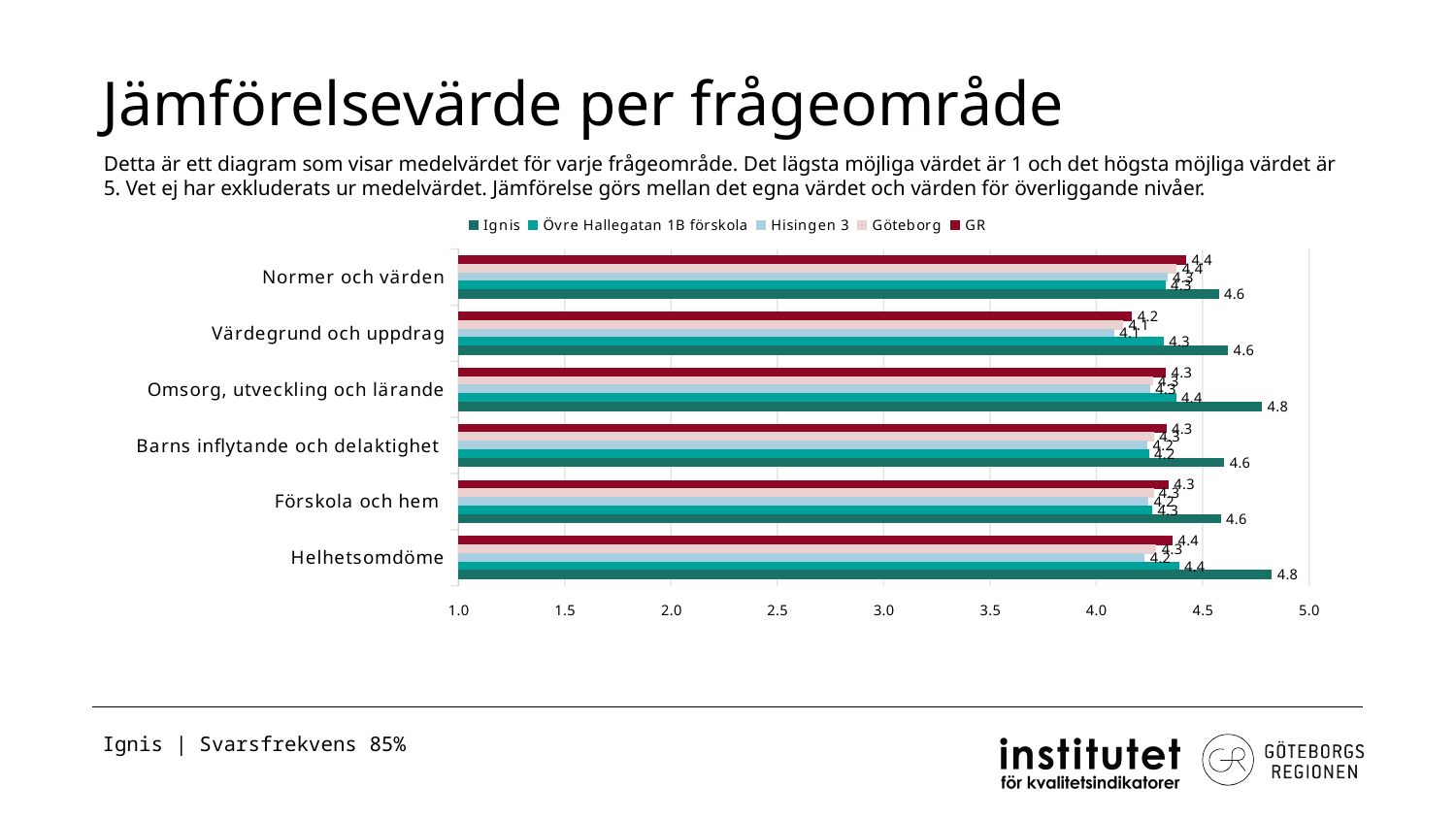
What kind of chart is shown on the slide? bar chart Is the Ignis value for Helhetsomdöme greater or less than 4.5? greater How many question areas (categories) are shown on the chart? 6 For Normer och värden, which is larger: the Ignis value or the Övre Hallegatan 1B förskola value? Ignis What is the title of the chart on the slide? Jämförelsevärde per frågeområde What is the Ignis value for Omsorg, utveckling och lärande? 4.8 What is the difference between the Ignis value and the Övre Hallegatan 1B förskola value for Omsorg, utveckling och lärande? 0.4 What is the Ignis value for Normer och värden? 4.6 How many series does the legend list? 5 What is the highest Ignis value shown on the chart? 4.8 What is the value for Övre Hallegatan 1B förskola for Barns inflytande och delaktighet? 4.2 What is the value for Övre Hallegatan 1B förskola for Helhetsomdöme? 4.4